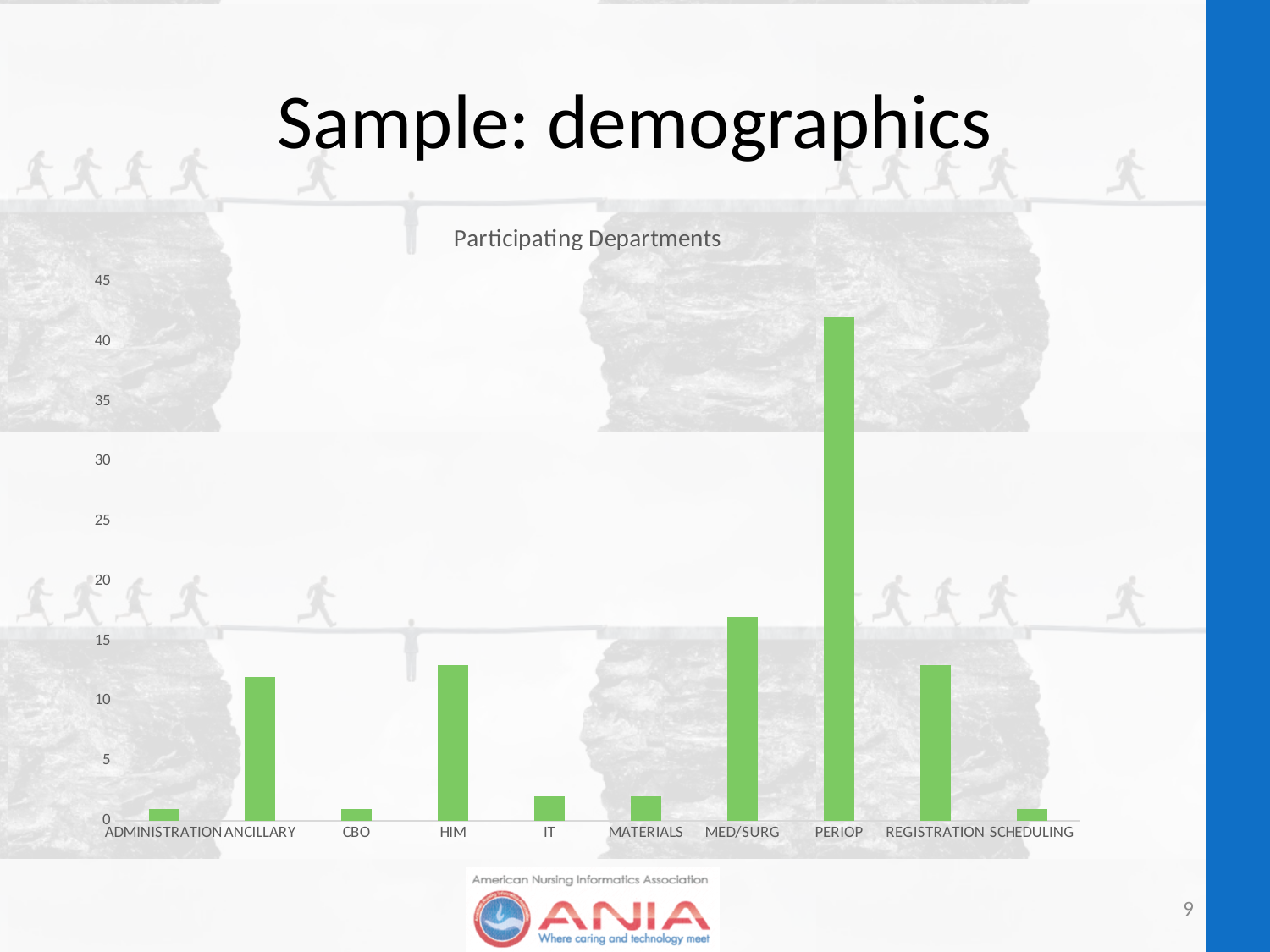
Which has the larger value, PERIOP or REGISTRATION? PERIOP Is the value for IT greater or less than 5? less What is the title of the chart? Participating Departments Which department has the highest bar in the chart? PERIOP Is the value for MED/SURG greater or less than 15? greater Is the value for PERIOP greater or less than 40? greater What kind of chart is shown on the slide? bar chart Which has the larger value, MED/SURG or ANCILLARY? MED/SURG What colour are the bars in the chart? green How many departments are shown on the x axis of the chart? 10